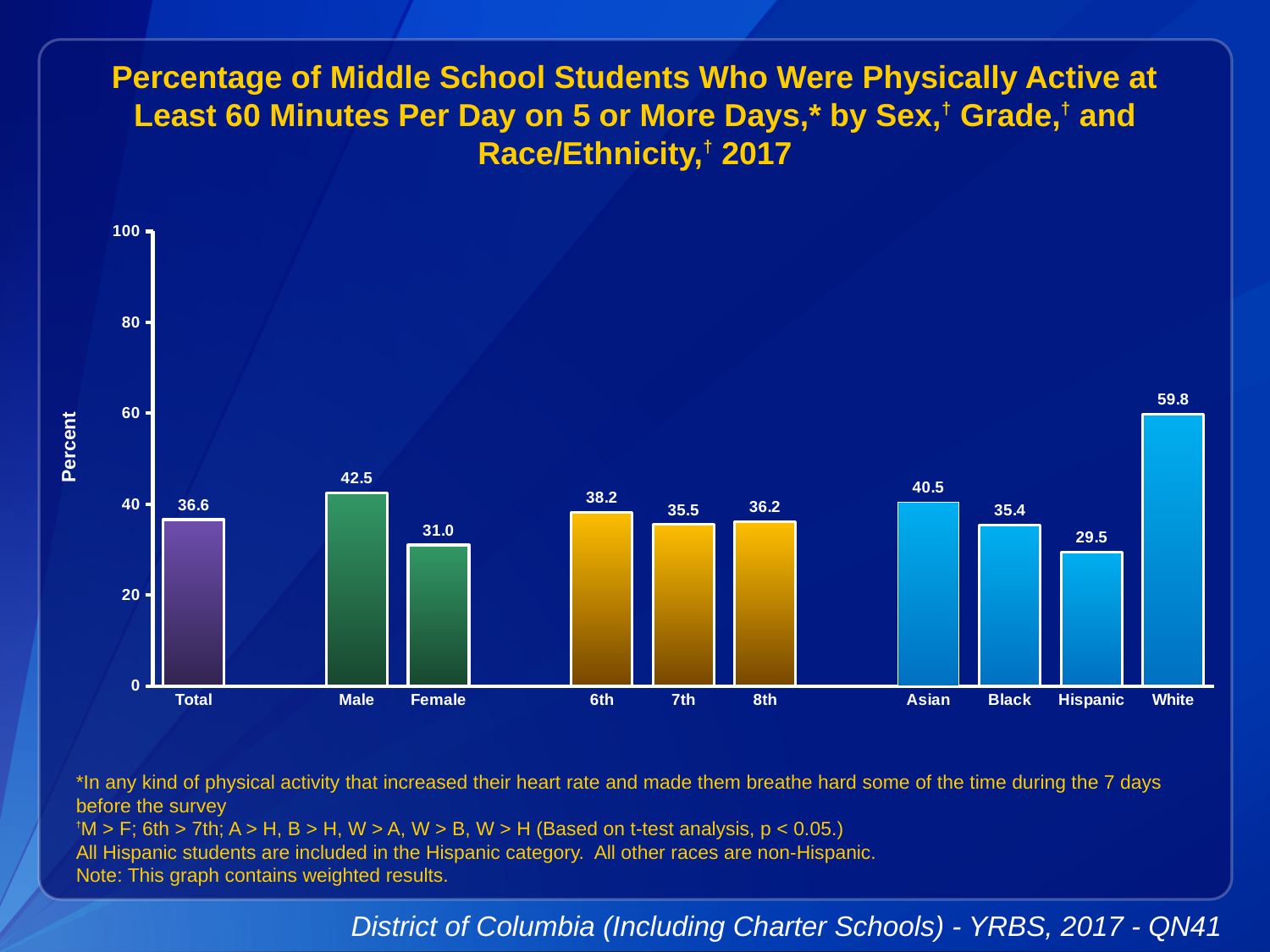
What is the value for Hispanic? 29.5 What is the difference between the values for Male and Female? 11.5 What kind of chart is this? bar chart What is the label of the y axis? Percent How many categories are shown on the x axis? 10 What is the value for Total? 36.6 Which category has the lowest value? Hispanic What is the difference between the values for White and Asian? 19.3 Is the value for White greater or less than 40? greater Which category has the highest value? White What is the value for Female? 31.0 Which is larger, the value for 6th or the value for 8th? 6th